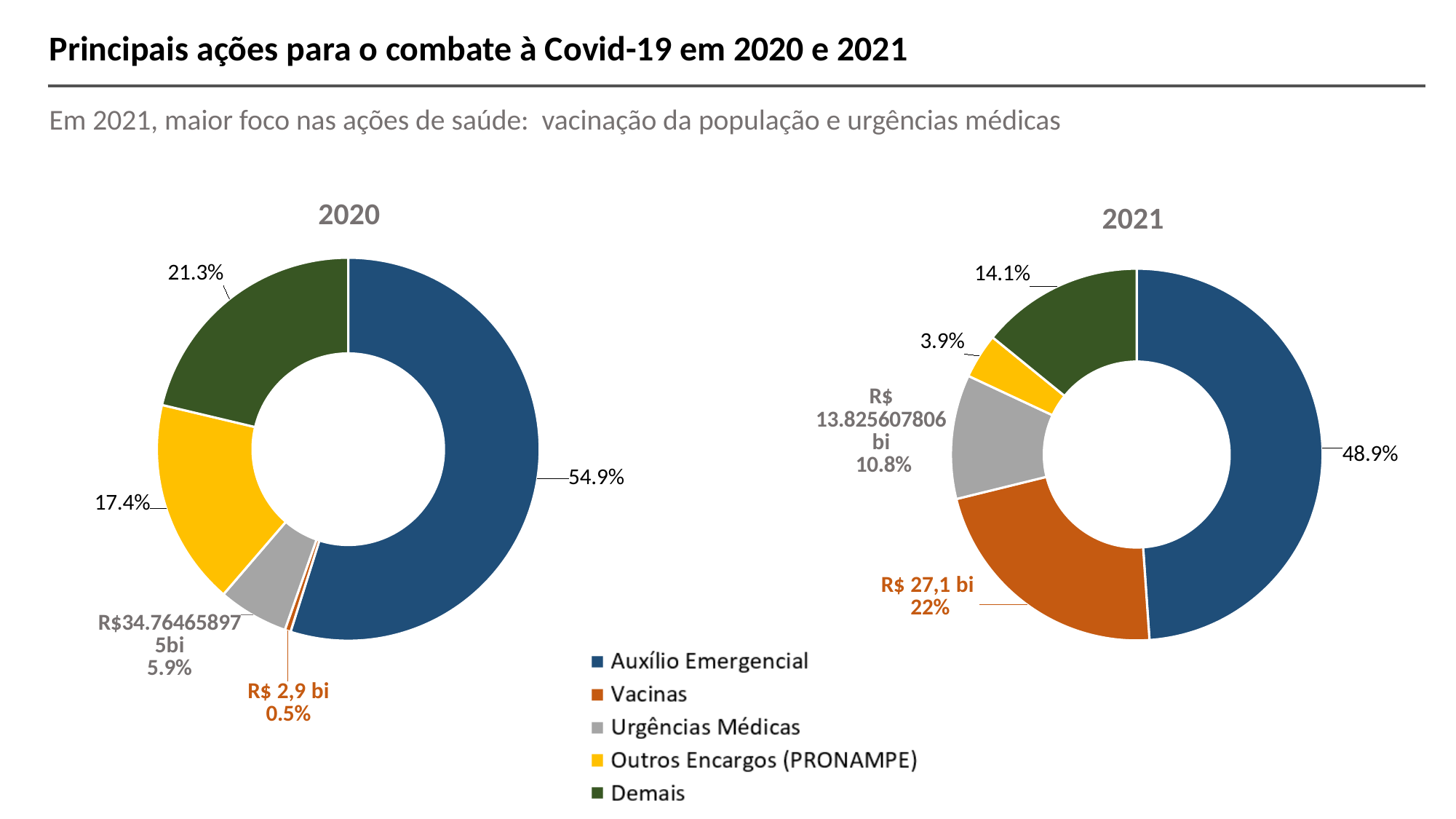
In the 2021 chart, what amount in reais is labelled for Vacinas? R$ 27,1 bi In the 2020 chart, what share does Auxílio Emergencial have? 54.9% In the 2021 chart, which category has the smallest share? Outros Encargos (PRONAMPE) In the 2020 chart, which is larger: the share of Demais or the share of Outros Encargos (PRONAMPE)? Demais Which colour represents Urgências Médicas in the legend? Gray In the 2021 chart, what share does Vacinas have? 22% What is the difference between the Vacinas share in 2021 and in 2020? 21.5 percentage points In the 2020 chart, which category has the smallest share? Vacinas In the 2020 chart, what share does Outros Encargos (PRONAMPE) have? 17.4% How many categories does the legend list? 5 In the 2021 chart, which category has the largest share? Auxílio Emergencial What kind of chart is used for the 2020 and 2021 data? Donut (pie) chart